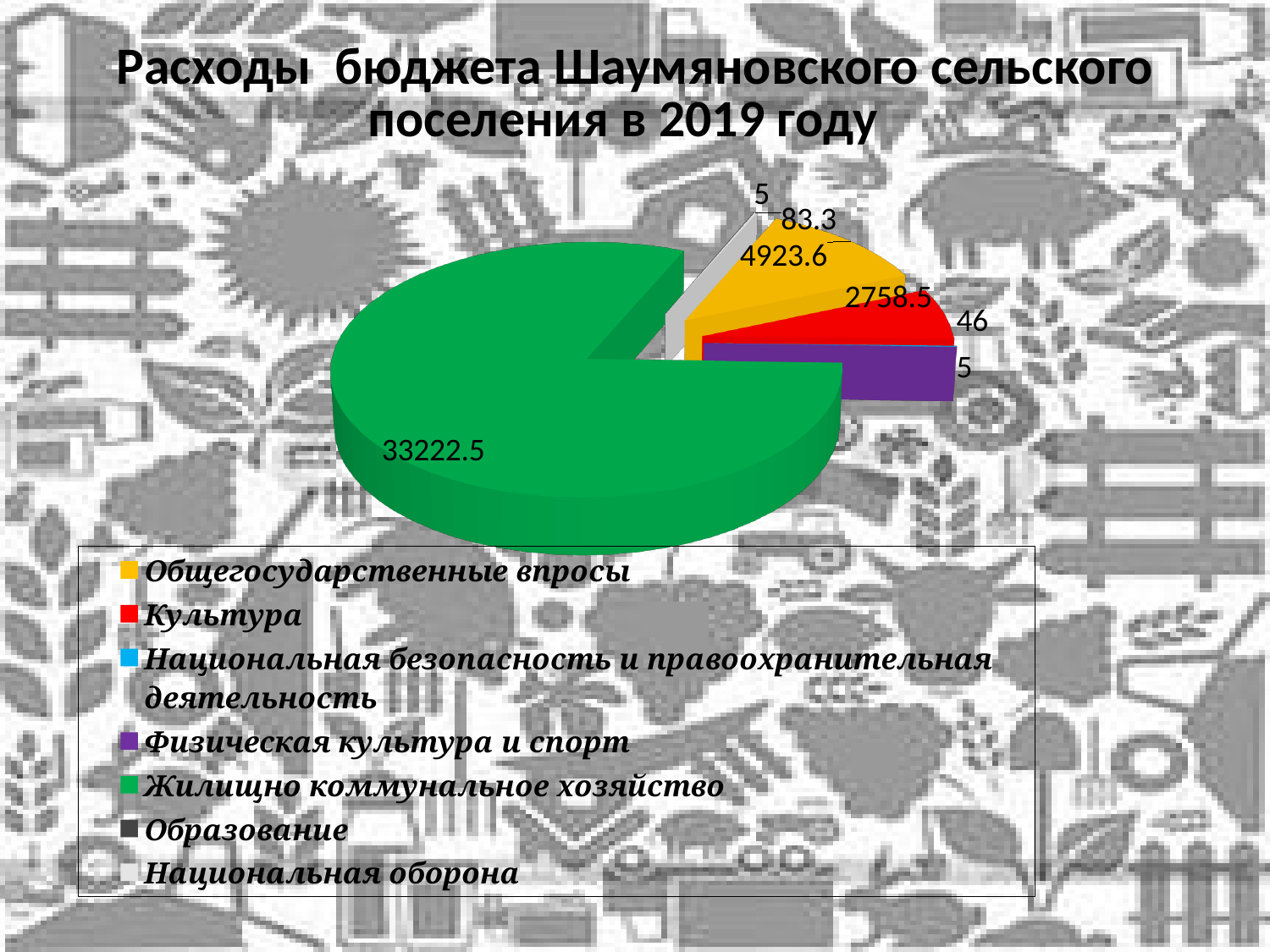
What kind of chart is shown on the slide? pie chart What is the difference between Общегосударственные впросы and Культура? 2165.1 Which category has the largest slice of the pie? Жилищно коммунальное хозяйство Which is larger, Жилищно коммунальное хозяйство or Культура? Жилищно коммунальное хозяйство Which is larger, Общегосударственные впросы or Культура? Общегосударственные впросы What colour is the slice for Жилищно коммунальное хозяйство? green What is the value for Культура? 2758.5 How many categories does the legend list? 7 What is the value for Общегосударственные впросы? 4923.6 What is the value for Жилищно коммунальное хозяйство? 33222.5 What is the title of the chart? Расходы бюджета Шаумяновского сельского поселения в 2019 году What is the difference between Жилищно коммунальное хозяйство and Общегосударственные впросы? 28298.9